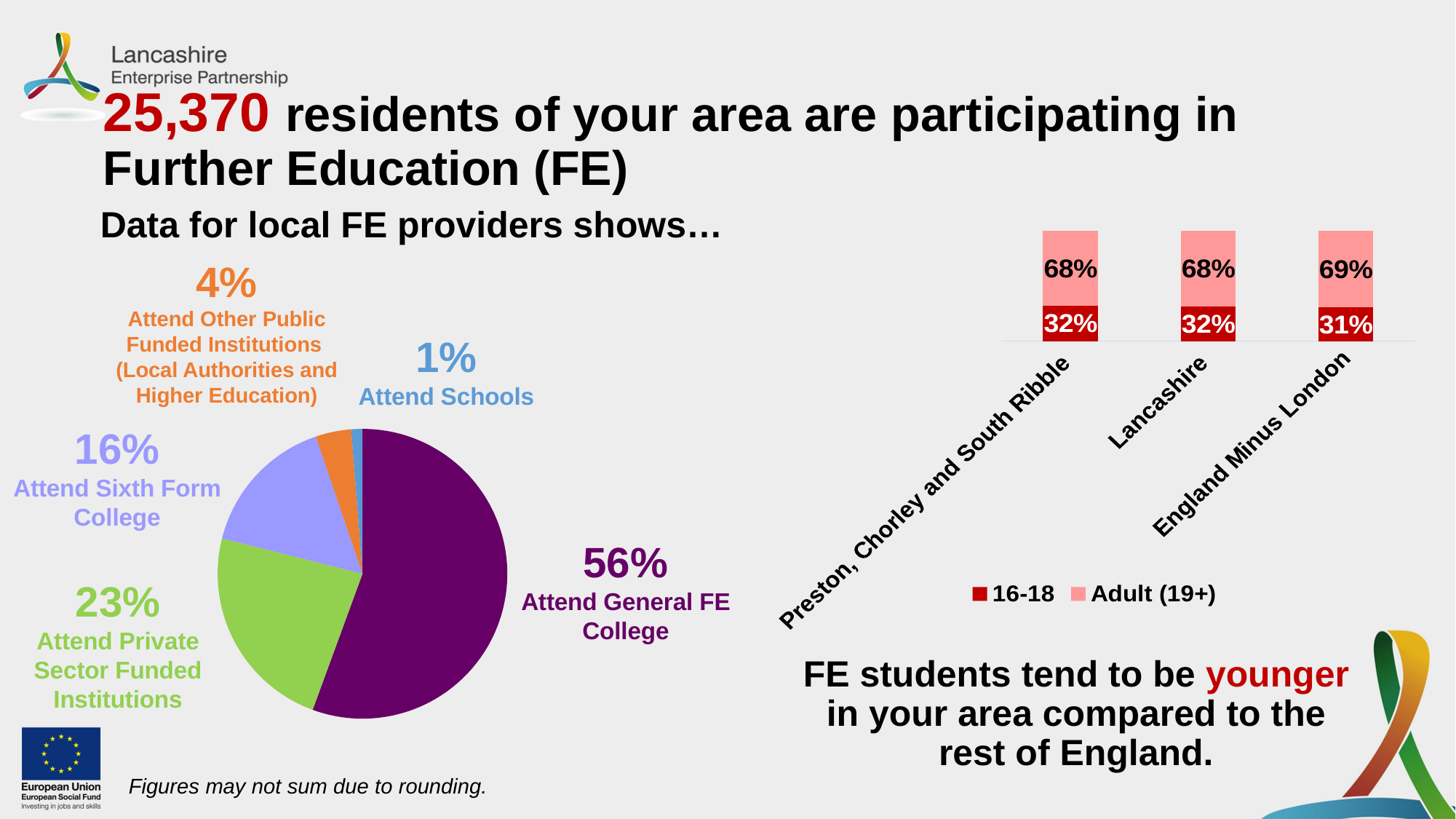
In the pie chart on the left, what share of FE participants attend General FE College? 56% In the stacked bar chart on the right, how many series does the legend list? 2 In the pie chart on the left, what share attend Private Sector Funded Institutions? 23% In the stacked bar chart on the right, what is the Adult (19+) value for England Minus London? 69% In the pie chart on the left, which category has the smallest share? Attend Schools In the pie chart on the left, what is the difference between the share attending Private Sector Funded Institutions and the share attending Sixth Form College? 7 percentage points In the pie chart on the left, what share attend Sixth Form College? 16% What kind of chart is shown on the right of the slide? Stacked bar chart In the stacked bar chart on the right, what is the total of the Lancashire bar? 100% In the pie chart on the left, how many categories are shown? 5 In the stacked bar chart on the right, what is the 16-18 value for Preston, Chorley and South Ribble? 32% In the pie chart on the left, which category has the largest share? Attend General FE College